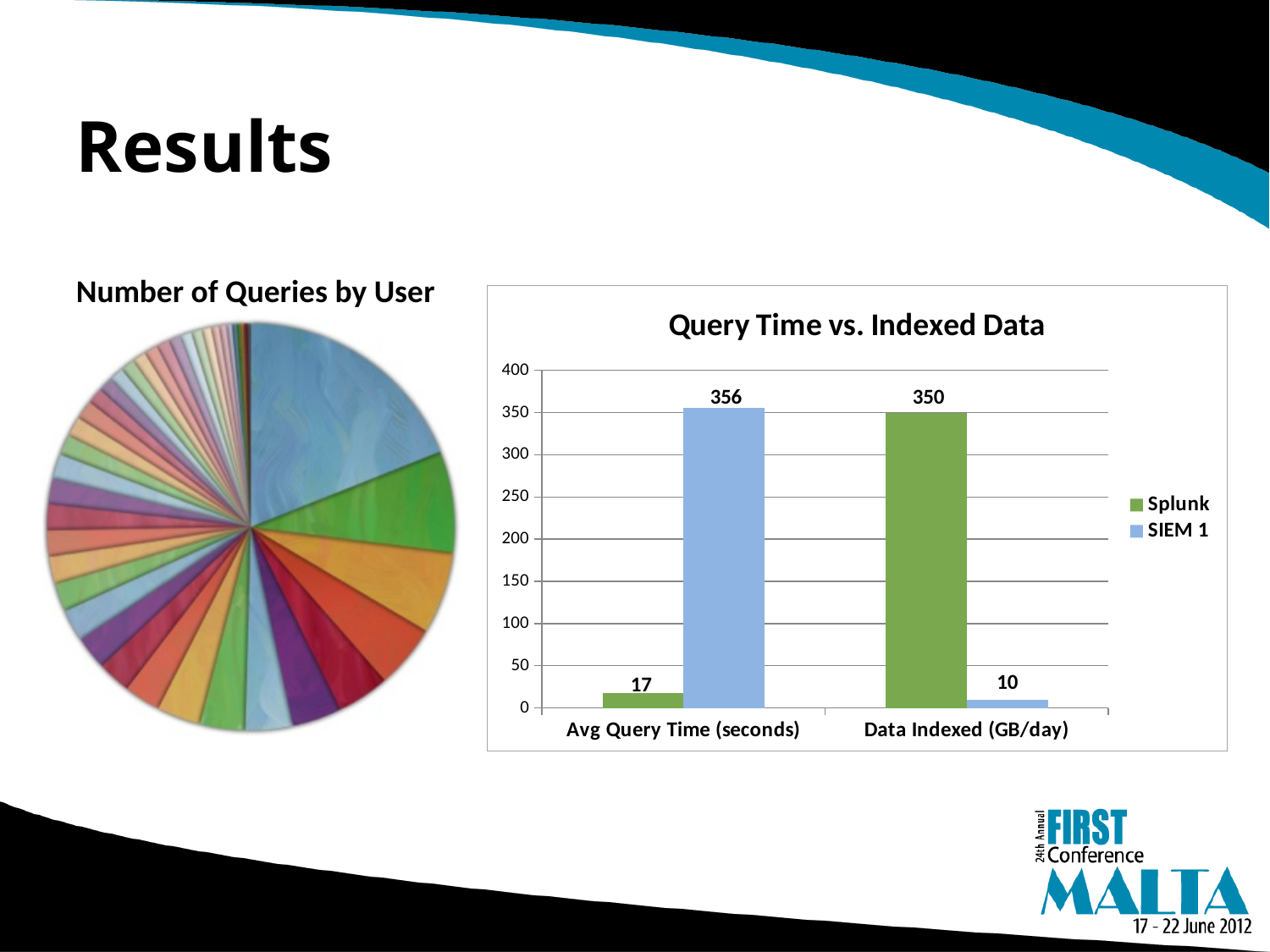
In the 'Query Time vs. Indexed Data' chart, what is the Avg Query Time (seconds) for Splunk? 17 In the 'Query Time vs. Indexed Data' chart, what is the Data Indexed (GB/day) value for SIEM 1? 10 In the 'Query Time vs. Indexed Data' chart, what is the difference between the Splunk and SIEM 1 values for Data Indexed (GB/day)? 340 What kind of chart is the 'Number of Queries by User' chart on the left of the slide? pie chart In the 'Query Time vs. Indexed Data' chart, what is the Data Indexed (GB/day) value for Splunk? 350 In the 'Query Time vs. Indexed Data' chart, how many categories are shown on the x axis? 2 What kind of chart is the 'Query Time vs. Indexed Data' chart? bar chart In the 'Query Time vs. Indexed Data' chart, which series has the higher Avg Query Time (seconds), Splunk or SIEM 1? SIEM 1 In the 'Query Time vs. Indexed Data' chart, which series has the higher Data Indexed (GB/day), Splunk or SIEM 1? Splunk In the 'Query Time vs. Indexed Data' chart, what is the Avg Query Time (seconds) for SIEM 1? 356 In the 'Query Time vs. Indexed Data' chart, what is the difference between the SIEM 1 and Splunk values for Avg Query Time (seconds)? 339 In the 'Query Time vs. Indexed Data' chart, how many series does the legend list? 2